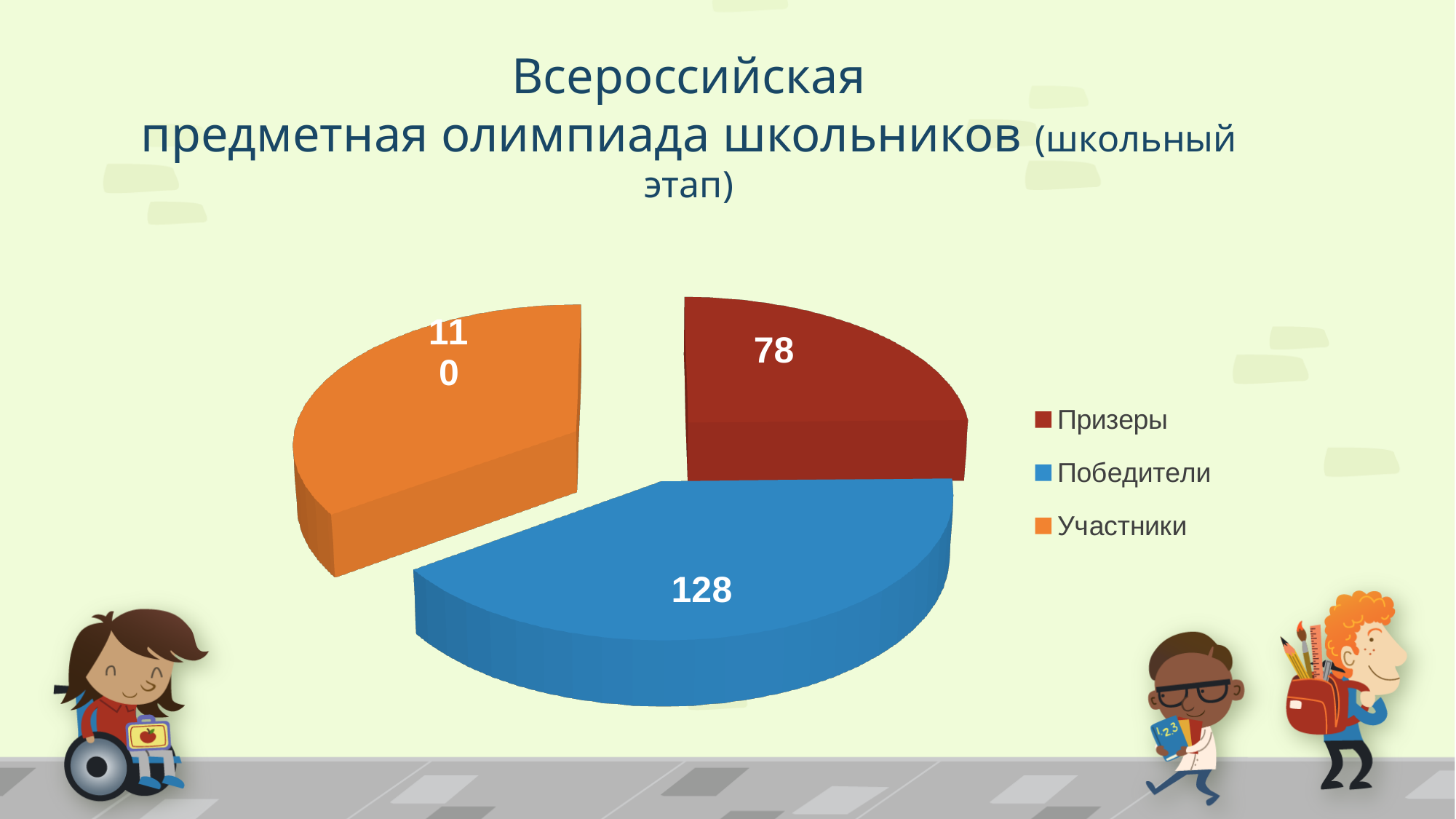
What is the value for Победители? 128 What is the total of all three slices? 316 How many entries does the legend list? 3 Which is larger, the value for Участники or the value for Призеры? Участники What is the value for Участники? 110 Which category has the smallest slice? Призеры How many slices does the pie chart have? 3 What is the difference between the values for Победители and Призеры? 50 Which colour represents Победители in the chart? Blue What kind of chart is shown on the slide? Pie chart What is the value for Призеры? 78 Which category has the largest slice? Победители